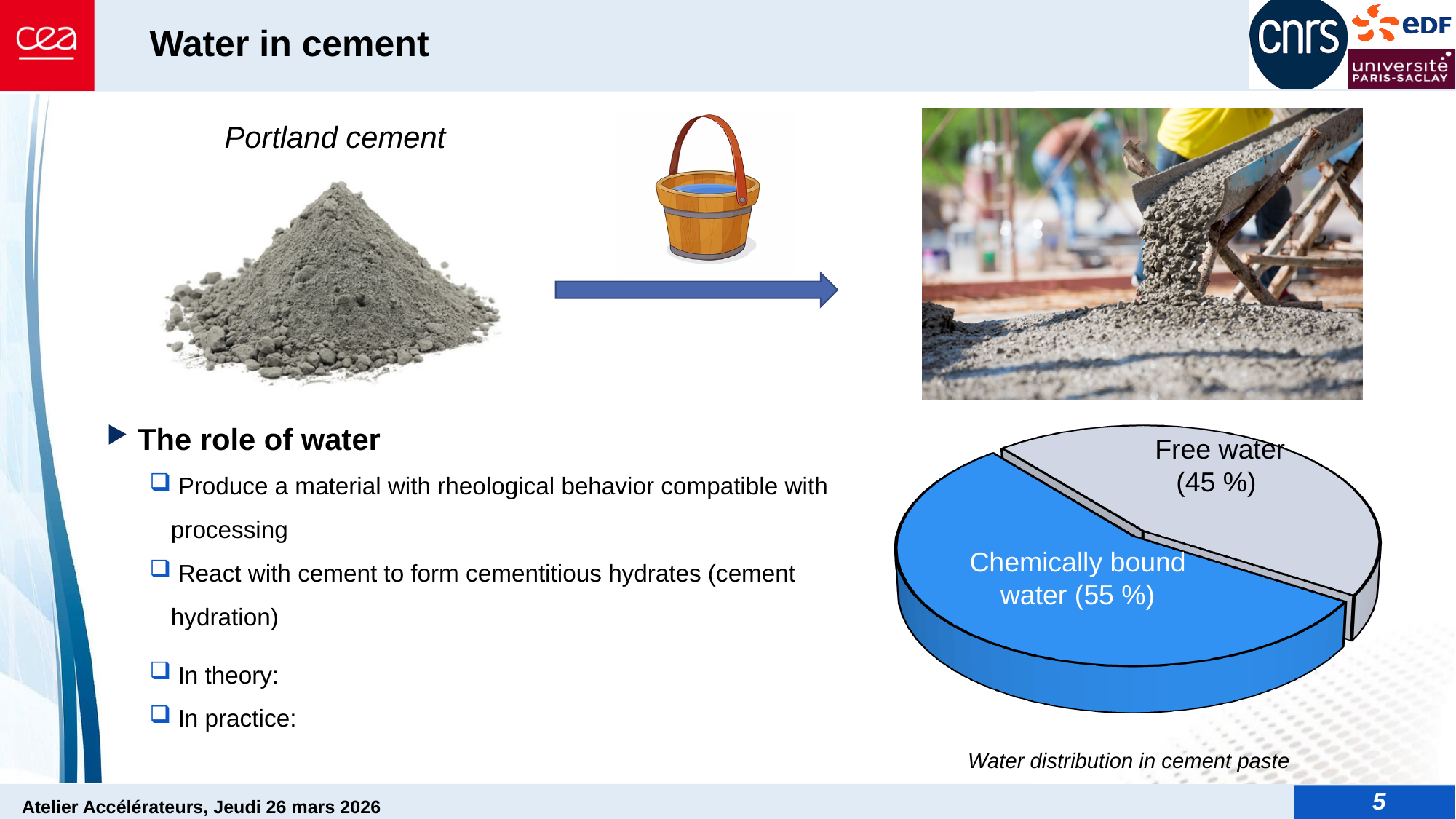
What is the difference in percentage points between Chemically bound water and Free water in the pie chart? 10 % What is the caption below the pie chart? Water distribution in cement paste What share of the pie chart is Chemically bound water? 55 % What colour is the Chemically bound water slice in the pie chart? blue Which slice of the pie chart is the largest? Chemically bound water Which slice of the pie chart is the smallest? Free water Is the share of Free water in the pie chart greater or less than 50 %? less What kind of chart is shown on the slide? pie chart Which is larger in the pie chart, Free water or Chemically bound water? Chemically bound water What share of the pie chart is Free water? 45 % How many slices does the pie chart have? 2